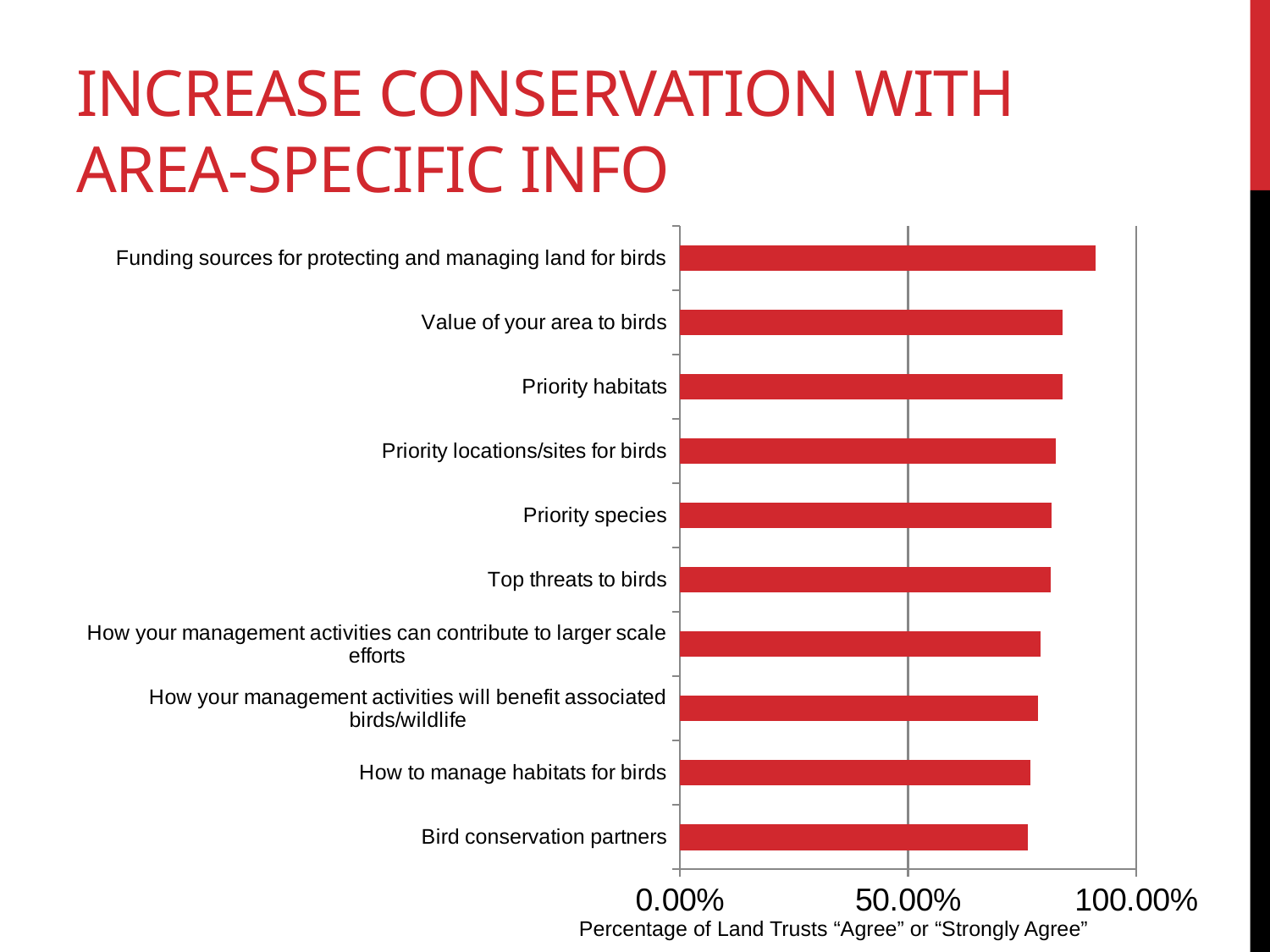
What is the title of the slide containing the chart? INCREASE CONSERVATION WITH AREA-SPECIFIC INFO Which is larger: the value for Funding sources for protecting and managing land for birds or the value for Bird conservation partners? Funding sources for protecting and managing land for birds What is the label on the horizontal axis of the chart? Percentage of Land Trusts "Agree" or "Strongly Agree" How many categories are plotted in the chart? 10 Is the value for Funding sources for protecting and managing land for birds greater or less than 100.00%? less Is the value for How to manage habitats for birds greater or less than 50.00%? greater Which category has the highest value in the chart? Funding sources for protecting and managing land for birds Is the value for Bird conservation partners greater or less than 50.00%? greater Which is larger: the value for Value of your area to birds or the value for How to manage habitats for birds? Value of your area to birds Which is larger: the value for Priority species or the value for Funding sources for protecting and managing land for birds? Funding sources for protecting and managing land for birds Do the bar lengths generally increase or decrease from the top category to the bottom category? decrease What kind of chart is shown on the slide? bar chart